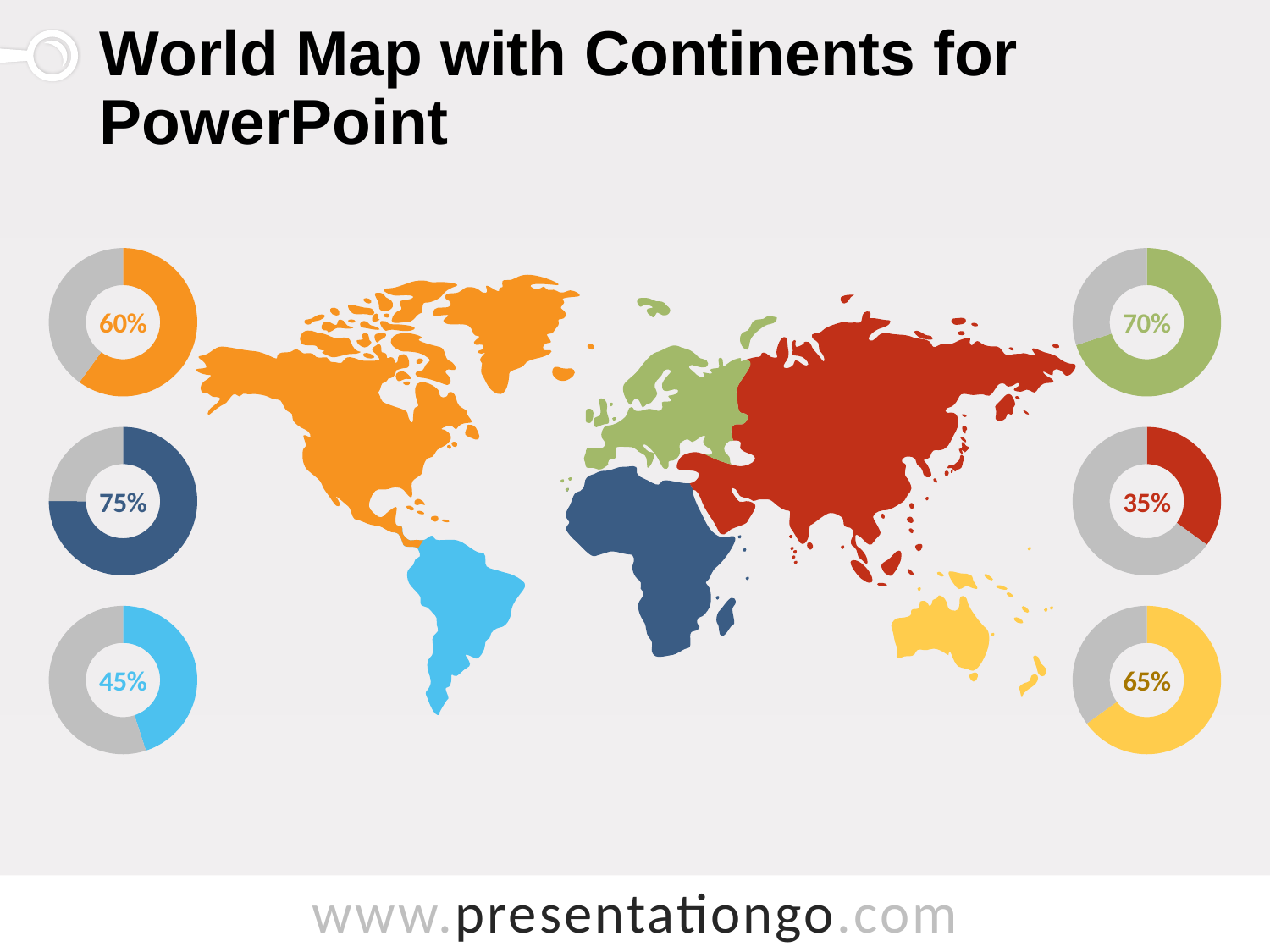
What kind of charts are shown on either side of the world map? Donut charts Which donut chart shows the highest percentage? The middle-left (dark blue) chart, 75% What value is shown in the middle-left donut chart (dark blue)? 75% What value is shown in the bottom-right donut chart (yellow)? 65% How many donut charts are on the slide? 6 What is the difference between the value in the middle-left (dark blue) donut chart and the value in the middle-right (red) donut chart? 40% What value is shown in the middle-right donut chart (red)? 35% What value is shown in the bottom-left donut chart (light blue)? 45% What value is shown in the top-right donut chart (green)? 70% Which is larger: the value in the top-right (green) donut chart or the value in the bottom-right (yellow) donut chart? The top-right (green) chart, 70% Which donut chart shows the lowest percentage? The middle-right (red) chart, 35% What value is shown in the top-left donut chart (orange)? 60%